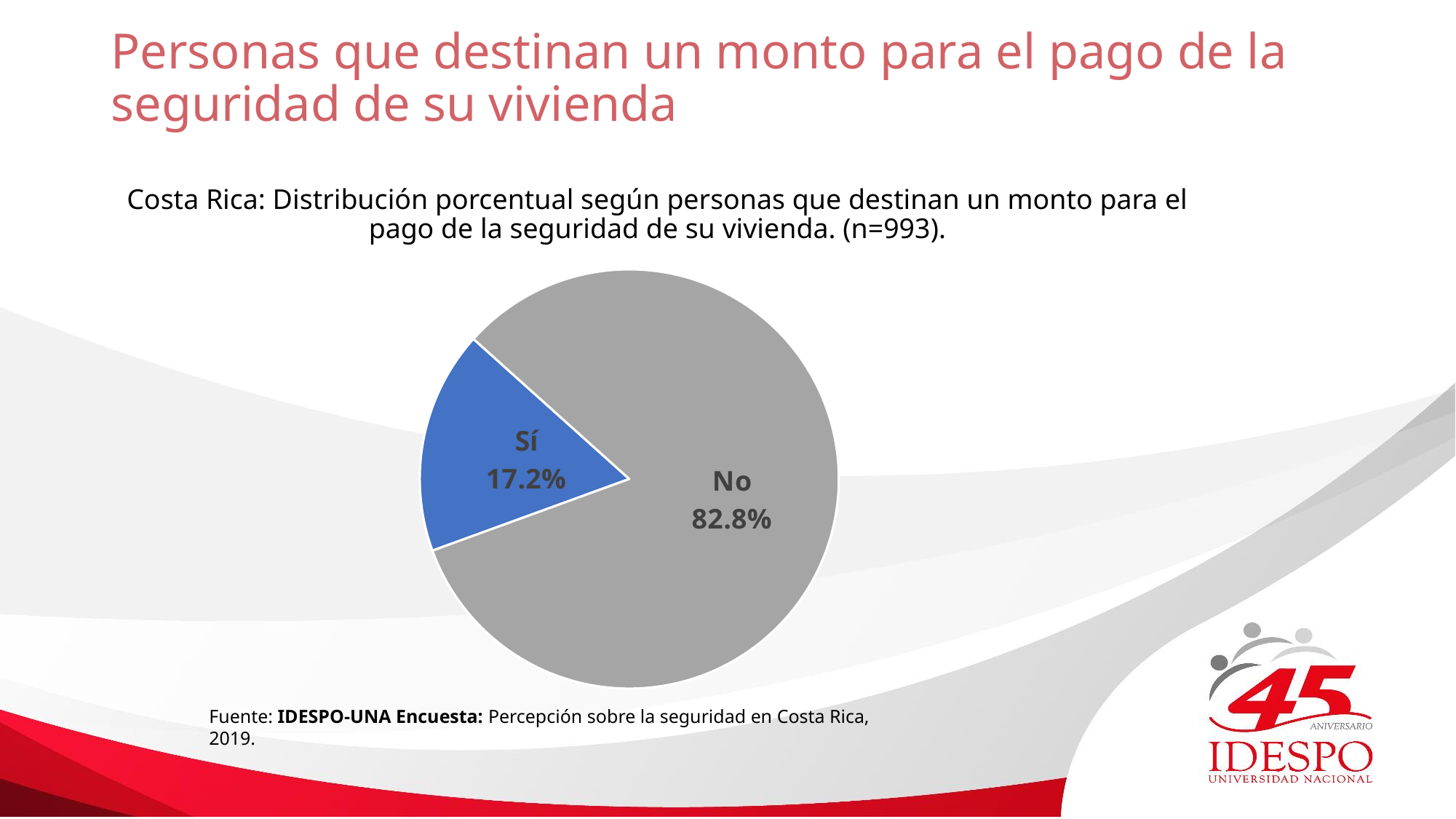
What is the difference in percentage points between the "No" and "Sí" slices? 65.6 Which category has the largest share of the pie chart? No What is the sample size (n) stated in the chart title? 993 Which slice is larger, "Sí" or "No"? No What type of chart is shown on the slide? Pie chart What percentage of the pie chart corresponds to "Sí"? 17.2% Is the share for "Sí" greater or less than 20%? less What percentage of the pie chart corresponds to "No"? 82.8% What colour is the "Sí" slice of the pie chart? Blue What share of the pie does the "No" slice represent? 82.8% How many slices does the pie chart have? 2 Which category has the smallest share of the pie chart? Sí